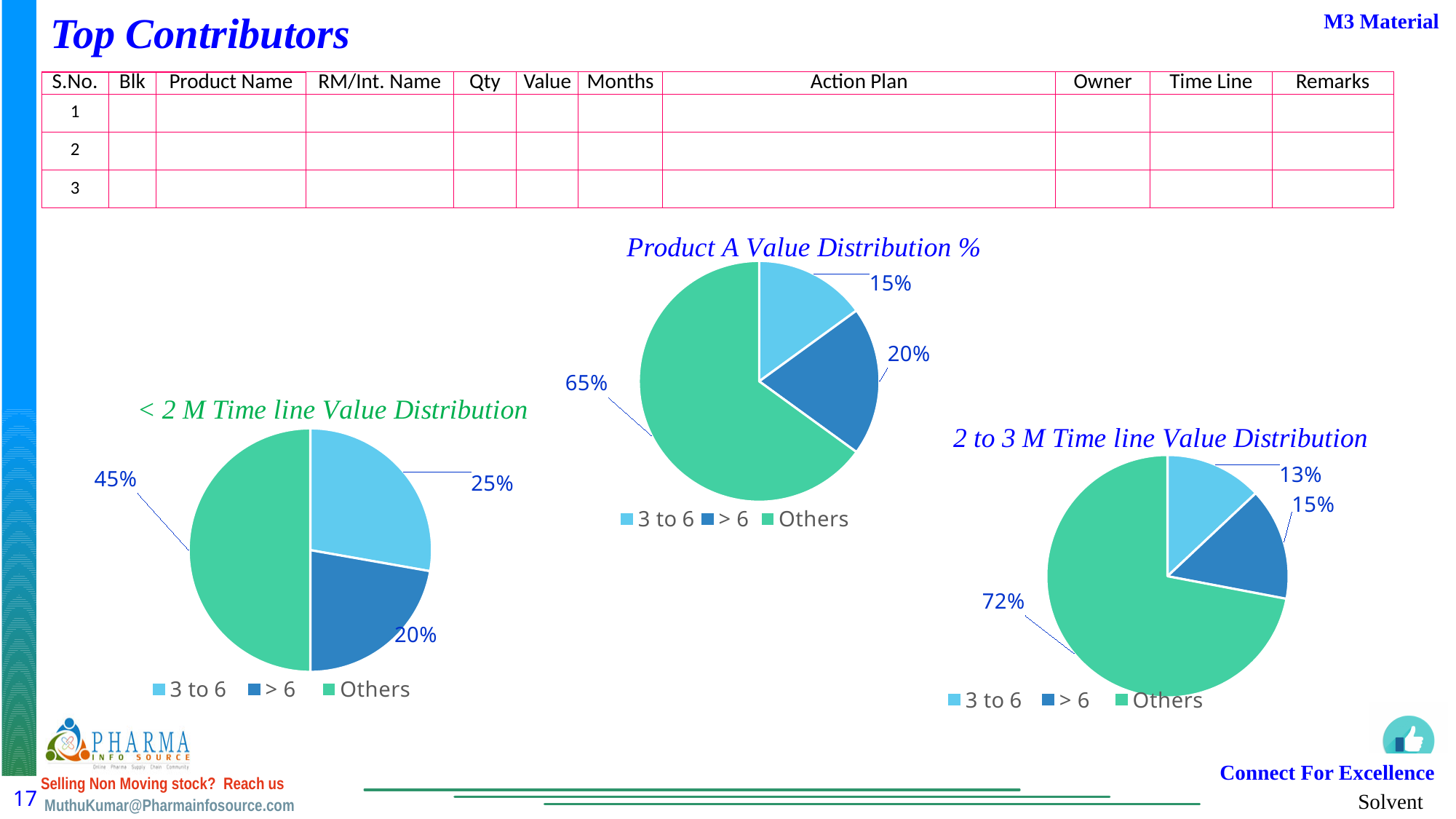
In the '2 to 3 M Time line Value Distribution' chart, what is the value for 'Others'? 72% In the '2 to 3 M Time line Value Distribution' chart, what is the value for '3 to 6'? 13% In the 'Product A Value Distribution %' chart, what is the value for '3 to 6'? 15% In the '2 to 3 M Time line Value Distribution' chart, which category has the largest slice? Others In the '< 2 M Time line Value Distribution' chart, what is the value for '> 6'? 20% In the 'Product A Value Distribution %' chart, what share does 'Others' have? 65% How many series does the legend of the '< 2 M Time line Value Distribution' chart list? 3 In the '2 to 3 M Time line Value Distribution' chart, which is larger, '3 to 6' or '> 6'? > 6 In the 'Product A Value Distribution %' chart, which category has the smallest slice? 3 to 6 In the '< 2 M Time line Value Distribution' chart, what is the difference between 'Others' and '3 to 6'? 20% In the '< 2 M Time line Value Distribution' chart, what is the value for '3 to 6'? 25% What type of chart is the 'Product A Value Distribution %' chart? Pie chart